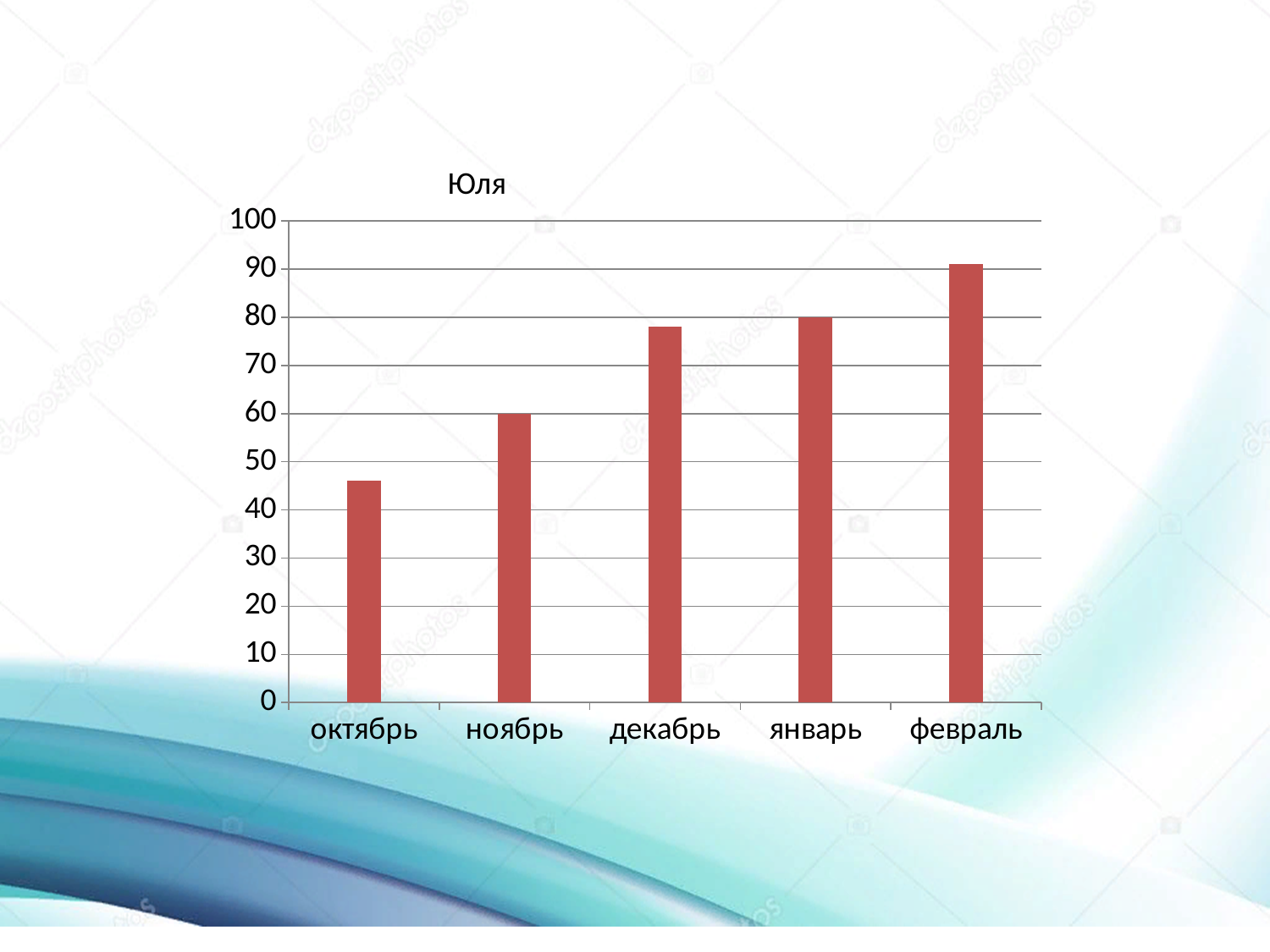
Which is larger, the value for декабрь or the value for ноябрь? декабрь What is the value for ноябрь? 60 What kind of chart is shown on the slide? bar chart What is the title of the chart? Юля Do the values rise or fall from октябрь to февраль? rise What is the difference between the values for январь and ноябрь? 20 What is the value for январь? 80 Which month has the highest bar in the chart? февраль How many categories are shown on the x axis of the chart? 5 Is the value for октябрь greater or less than 50? less Which month has the lowest bar in the chart? октябрь